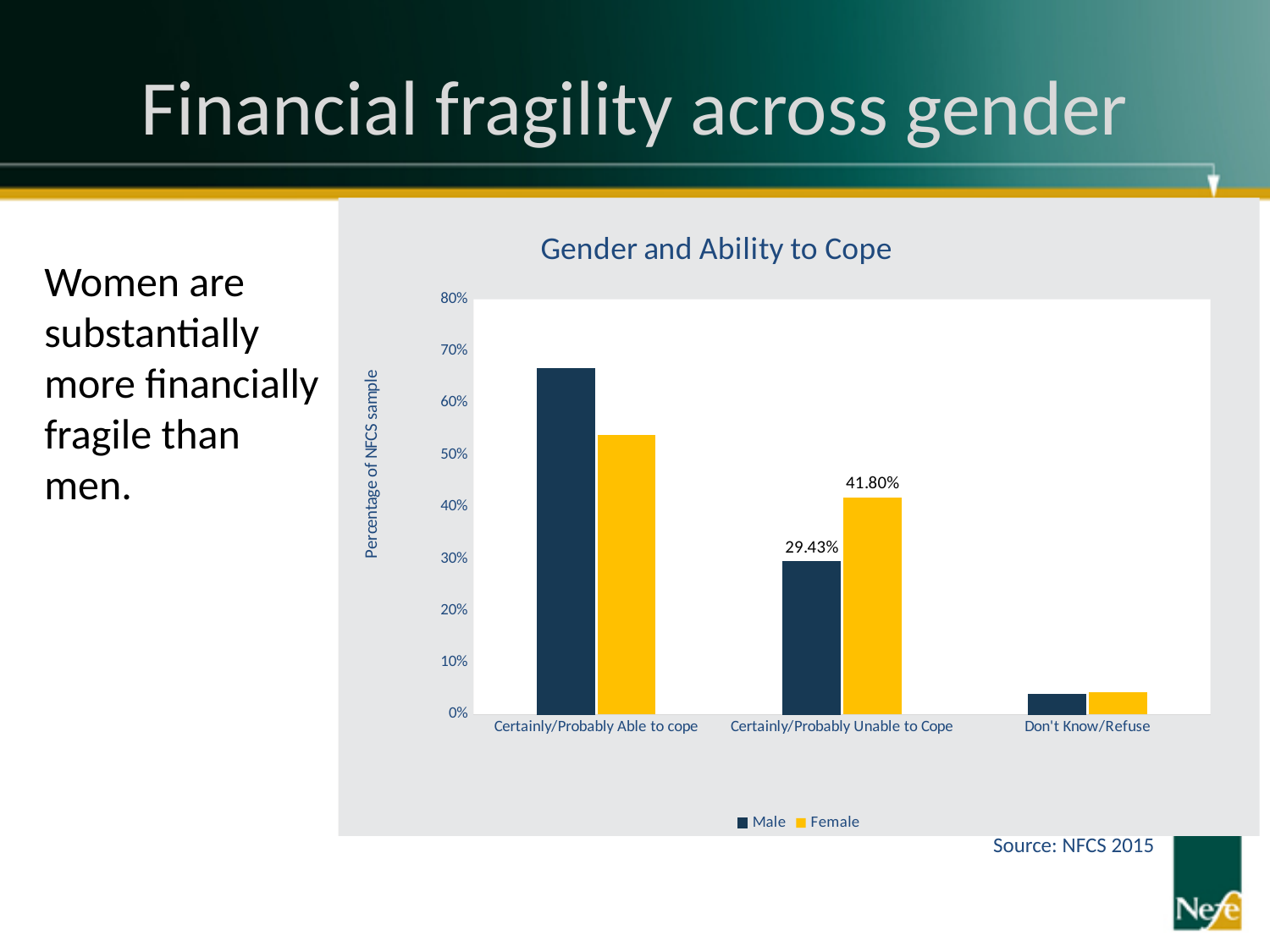
In the Certainly/Probably Unable to Cope category, which series has the larger value, Male or Female? Female Which category has the lowest value for Male? Don't Know/Refuse What is the value for Female in the Certainly/Probably Unable to Cope category? 41.80% Is the value for Female in the Don't Know/Refuse category greater or less than 10%? less What is the value for Male in the Certainly/Probably Unable to Cope category? 29.43% In the Certainly/Probably Able to cope category, which series has the larger value, Male or Female? Male Is the value for Female in the Certainly/Probably Able to cope category greater or less than 60%? less How many categories are shown on the x axis? 3 Which category has the highest value for Female? Certainly/Probably Able to cope What is the difference between the Female and Male values in the Certainly/Probably Unable to Cope category? 12.37% Is the value for Male in the Certainly/Probably Able to cope category greater or less than 60%? greater How many series does the legend list? 2